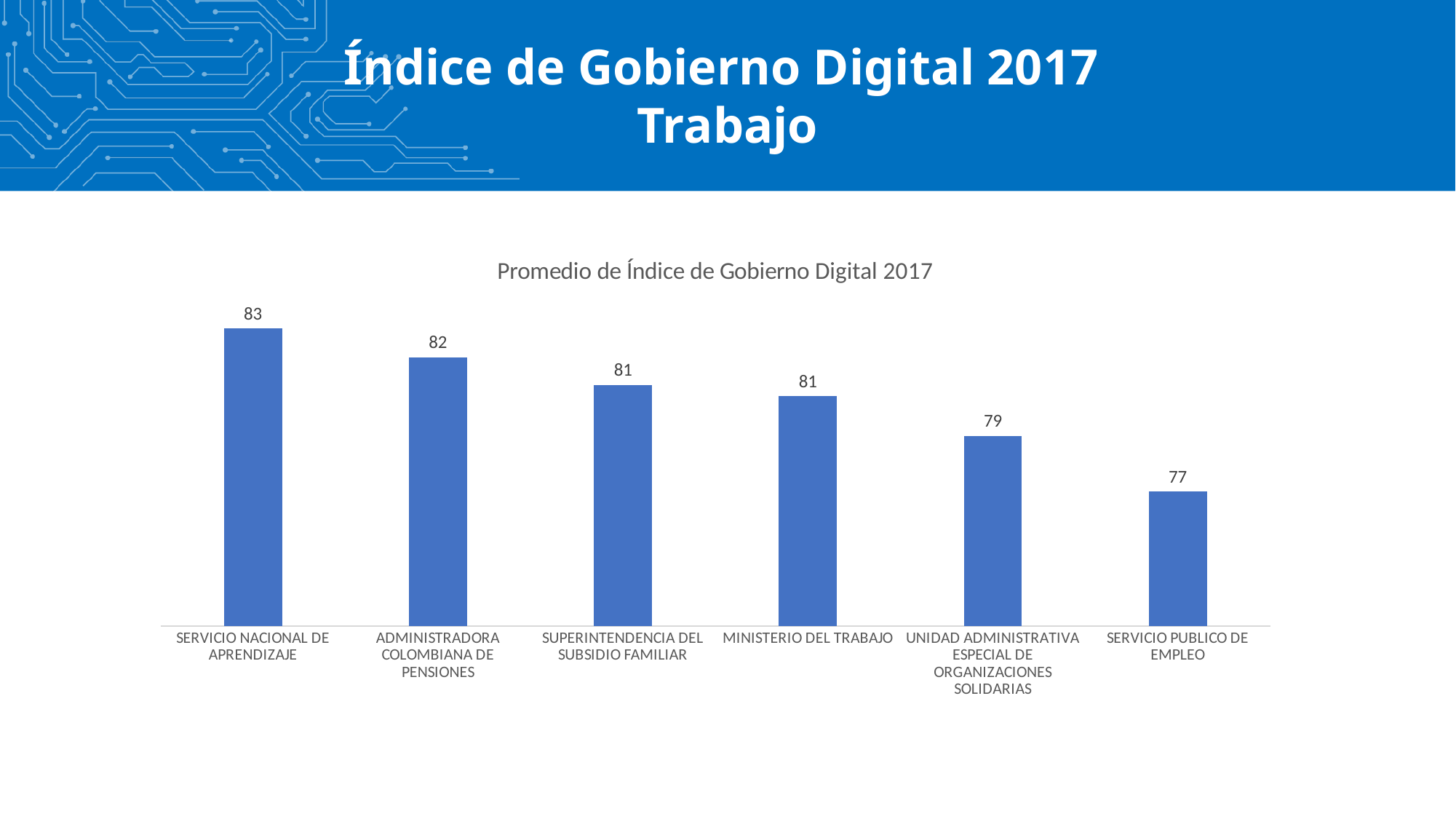
Which is larger, the value for UNIDAD ADMINISTRATIVA ESPECIAL DE ORGANIZACIONES SOLIDARIAS or the value for SERVICIO PUBLICO DE EMPLEO? UNIDAD ADMINISTRATIVA ESPECIAL DE ORGANIZACIONES SOLIDARIAS What is the value for SERVICIO PUBLICO DE EMPLEO? 77 What kind of chart is shown on the slide? Bar chart What is the value for MINISTERIO DEL TRABAJO? 81 What is the difference between the values for ADMINISTRADORA COLOMBIANA DE PENSIONES and UNIDAD ADMINISTRATIVA ESPECIAL DE ORGANIZACIONES SOLIDARIAS? 3 Which category has the lowest value? SERVICIO PUBLICO DE EMPLEO How many categories are shown in the chart? 6 What is the title of the chart? Promedio de Índice de Gobierno Digital 2017 What is the difference between the values for SERVICIO NACIONAL DE APRENDIZAJE and SERVICIO PUBLICO DE EMPLEO? 6 What is the value for SERVICIO NACIONAL DE APRENDIZAJE? 83 What is the value for ADMINISTRADORA COLOMBIANA DE PENSIONES? 82 Which category has the highest value? SERVICIO NACIONAL DE APRENDIZAJE